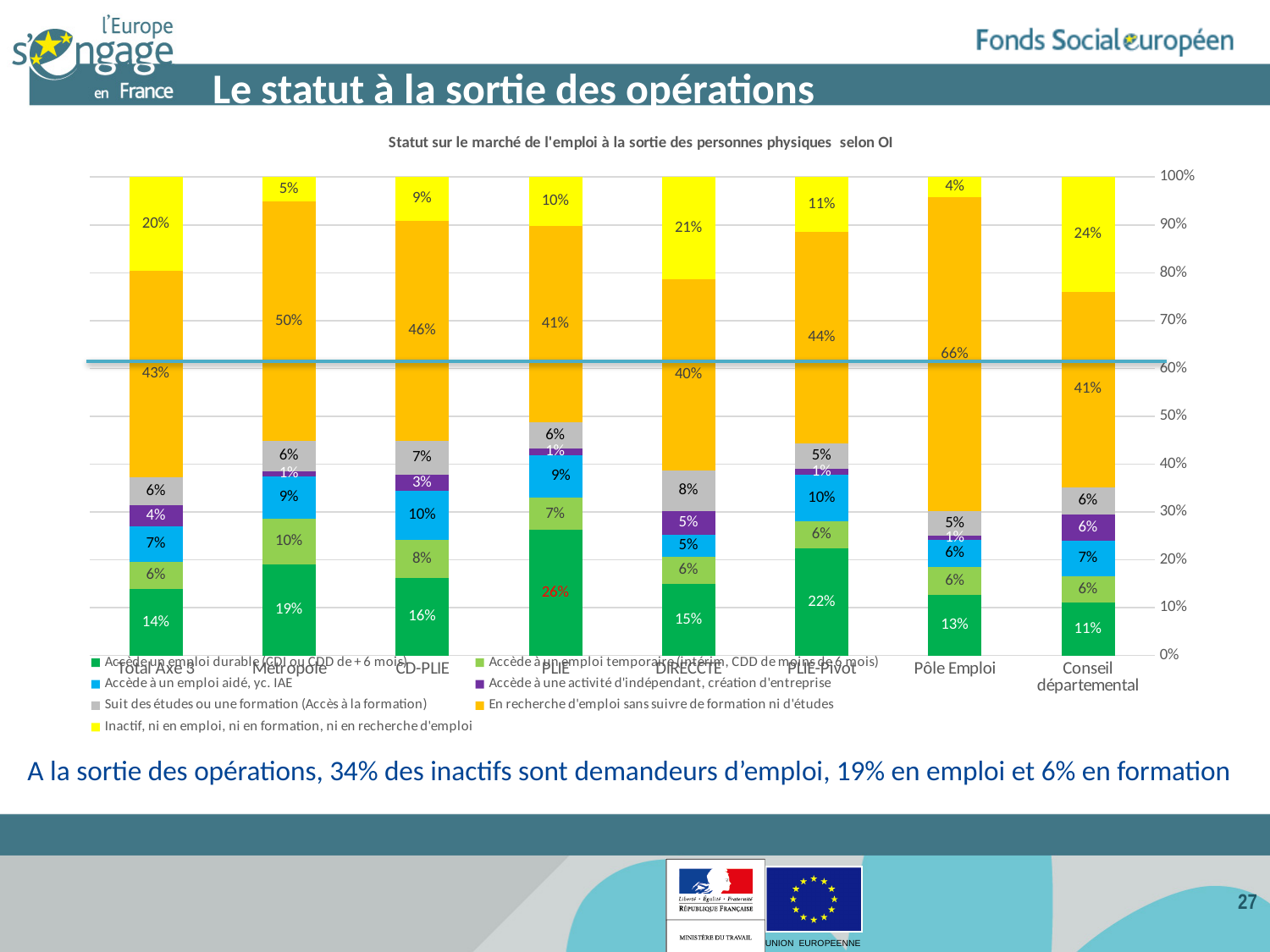
What kind of chart is shown on the slide? Stacked bar chart What is the title of the chart? Statut sur le marché de l'emploi à la sortie des personnes physiques selon OI What is the value of 'En recherche d'emploi sans suivre de formation ni d'études' for Pôle Emploi? 66% Which is larger: the 'Accède un emploi durable' value for Métropole or for CD-PLIE? Métropole How many categories (OI) are shown along the x axis of the chart? 8 What is the value of 'Inactif, ni en emploi, ni en formation, ni en recherche d'emploi' for Conseil départemental? 24% Which category has the highest value for 'Accède un emploi durable (CDI ou CDD de + 6 mois)'? PLIE What is the value of 'Accède un emploi durable (CDI ou CDD de + 6 mois)' for PLIE? 26% What is the difference between the 'En recherche d'emploi sans suivre de formation ni d'études' values for Pôle Emploi and Total Axe 3? 23% Which category has the lowest value for 'Inactif, ni en emploi, ni en formation, ni en recherche d'emploi'? Pôle Emploi What is the value of 'Suit des études ou une formation (Accès à la formation)' for DIRECCTE? 8% How many series does the chart legend list? 7